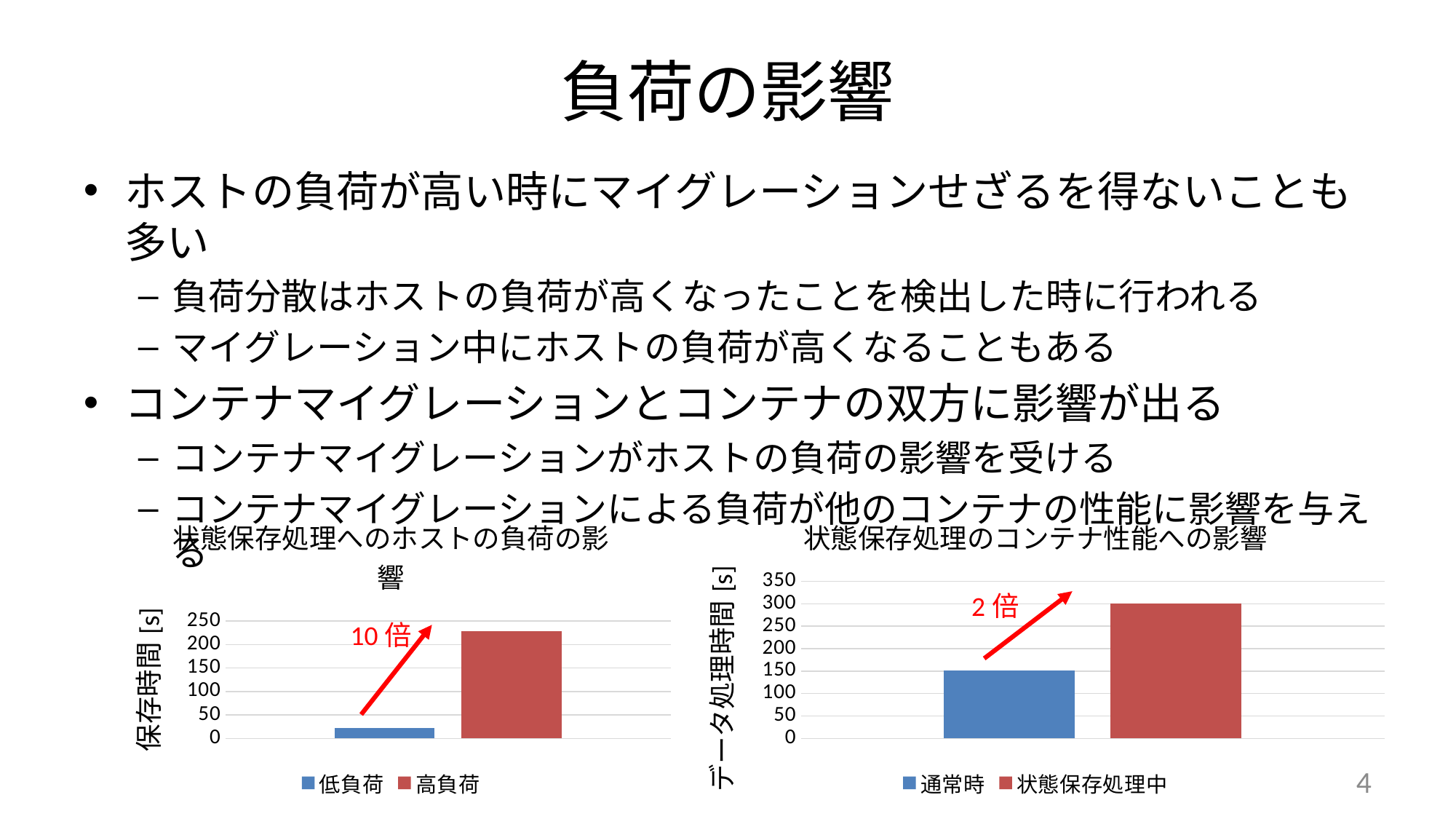
In the left chart (状態保存処理へのホストの負荷の影響), how many series does the legend list? 2 In the left chart (状態保存処理へのホストの負荷の影響), what is the label of the vertical axis? 保存時間 [s] In the right chart (状態保存処理のコンテナ性能への影響), which series has the higher データ処理時間? 状態保存処理中 In the right chart (状態保存処理のコンテナ性能への影響), what kind of chart is shown? bar chart In the right chart (状態保存処理のコンテナ性能への影響), is the value for 状態保存処理中 greater or less than 250? greater In the right chart (状態保存処理のコンテナ性能への影響), what ratio is written in red next to the arrow? 2 倍 In the left chart (状態保存処理へのホストの負荷の影響), which series has the lower 保存時間? 低負荷 In the left chart (状態保存処理へのホストの負荷の影響), is the value for 低負荷 greater or less than 50? less In the left chart (状態保存処理へのホストの負荷の影響), which series has the higher 保存時間? 高負荷 In the left chart (状態保存処理へのホストの負荷の影響), is the value for 高負荷 greater or less than 200? greater